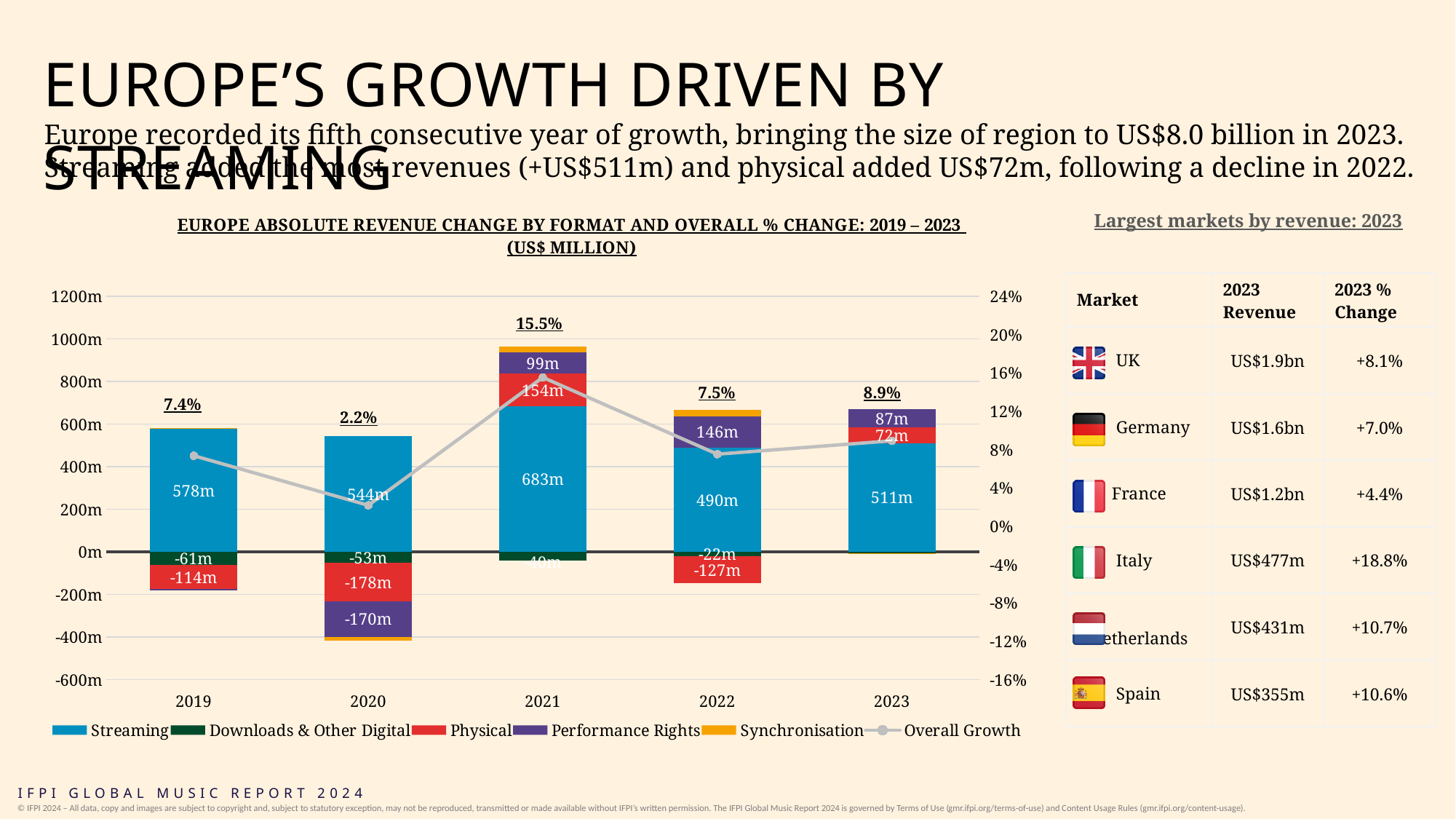
Which year has the lowest Overall Growth percentage? 2020 How many series does the chart legend list? 6 What is the difference between the Streaming values for 2021 and 2022? 193m What is the Streaming value for 2021? 683m Which year has the larger Performance Rights value, 2022 or 2023? 2022 What is the Physical value for 2020? -178m What kind of chart is used to show the revenue change by format? bar chart Which series in the legend is drawn as a line rather than bars? Overall Growth What is the Performance Rights value for 2020? -170m How many years are shown on the x axis of the chart? 5 Which year has the highest Streaming value? 2021 What is the Overall Growth percentage shown for 2021? 15.5%